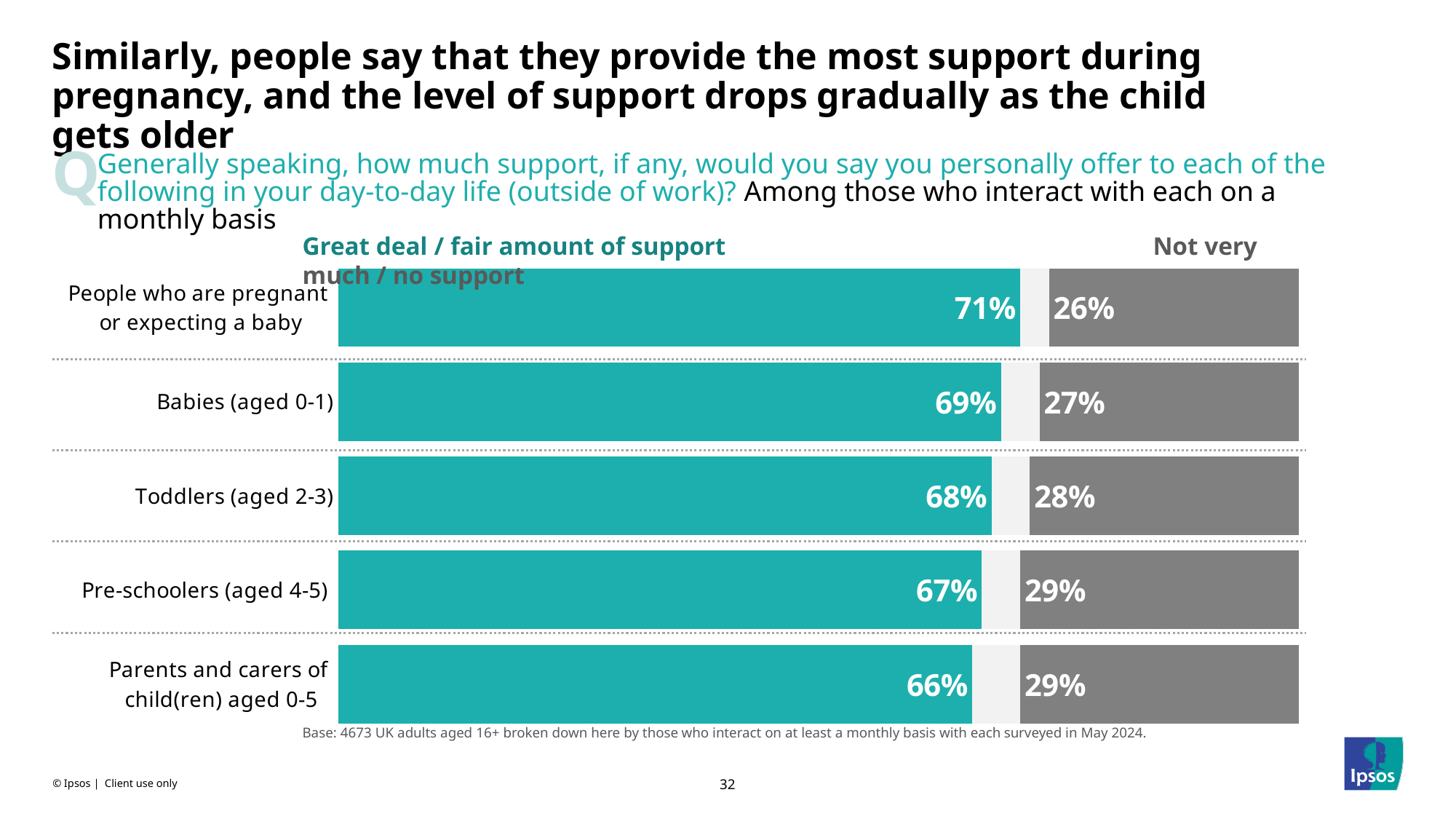
What percentage say they offer not very much / no support to toddlers (aged 2-3)? 28% What kind of chart is shown on the slide? Bar chart What is the difference in great deal / fair amount of support between people who are pregnant or expecting a baby and babies (aged 0-1)? 2 percentage points Do the great deal / fair amount of support values rise or fall going down the chart from pregnant people to parents and carers of child(ren) aged 0-5? Fall How many series does the chart show? 2 How many categories are shown in the chart? 5 What percentage of people say they offer a great deal / fair amount of support to people who are pregnant or expecting a baby? 71% Which category has the lowest great deal / fair amount of support value? Parents and carers of child(ren) aged 0-5 Which is larger: the not very much / no support value for babies (aged 0-1) or for pre-schoolers (aged 4-5)? Pre-schoolers (aged 4-5) Which category has the highest great deal / fair amount of support value? People who are pregnant or expecting a baby What is the great deal / fair amount of support value for parents and carers of child(ren) aged 0-5? 66% Which category has the lowest not very much / no support value? People who are pregnant or expecting a baby